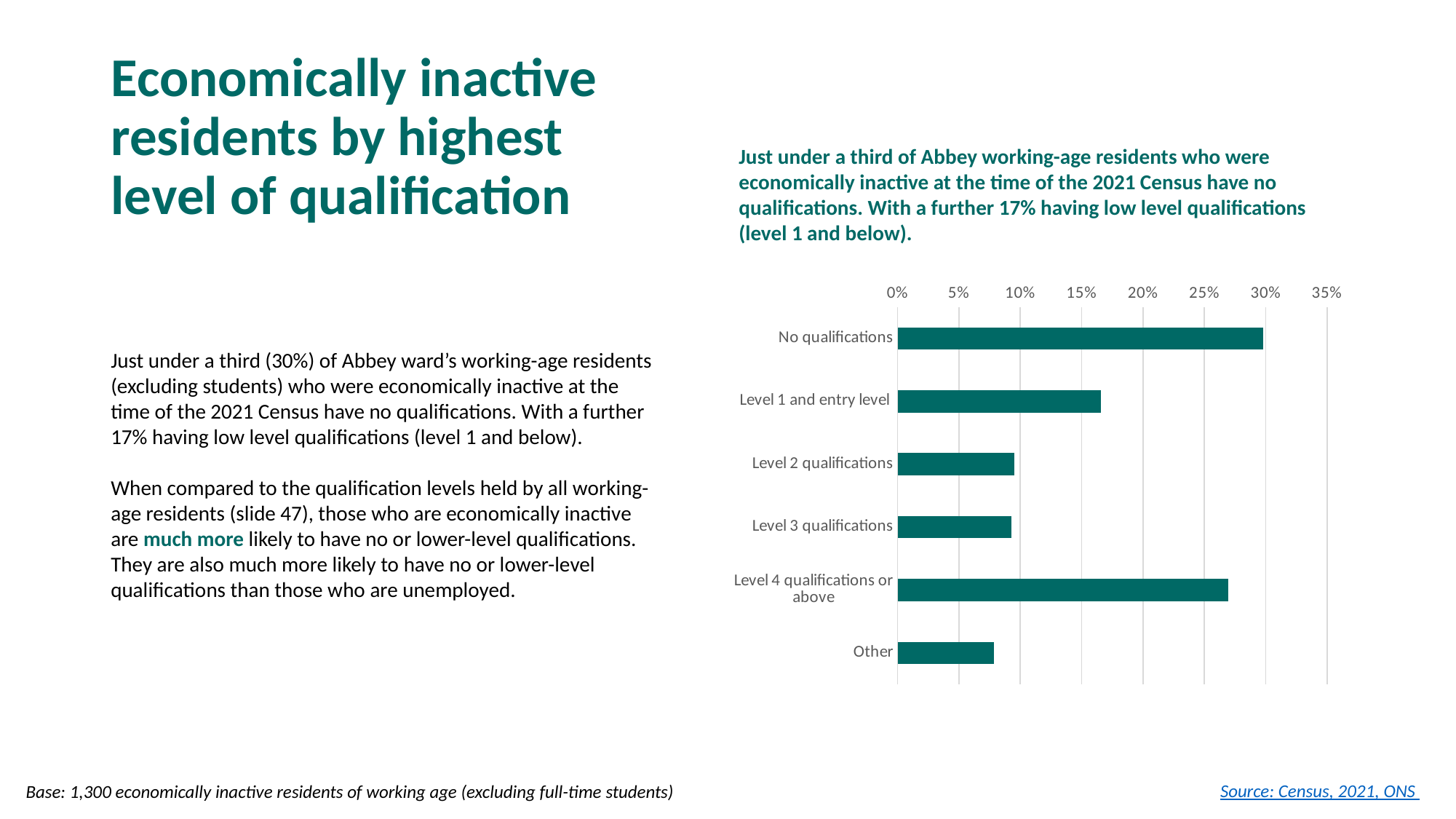
Which is larger, the value for Level 1 and entry level or the value for Level 2 qualifications? Level 1 and entry level How many qualification categories are shown in the chart? 6 Which qualification category has the highest value in the chart? No qualifications Which is larger, the value for No qualifications or the value for Level 4 qualifications or above? No qualifications What is the highest value shown on the chart's percentage axis? 35% What kind of chart is shown on the slide? bar chart Is the value for Level 1 and entry level greater or less than 15%? greater Is the value for Other greater or less than 10%? less Is the value for Level 4 qualifications or above greater or less than 25%? greater Which qualification category has the lowest value in the chart? Other